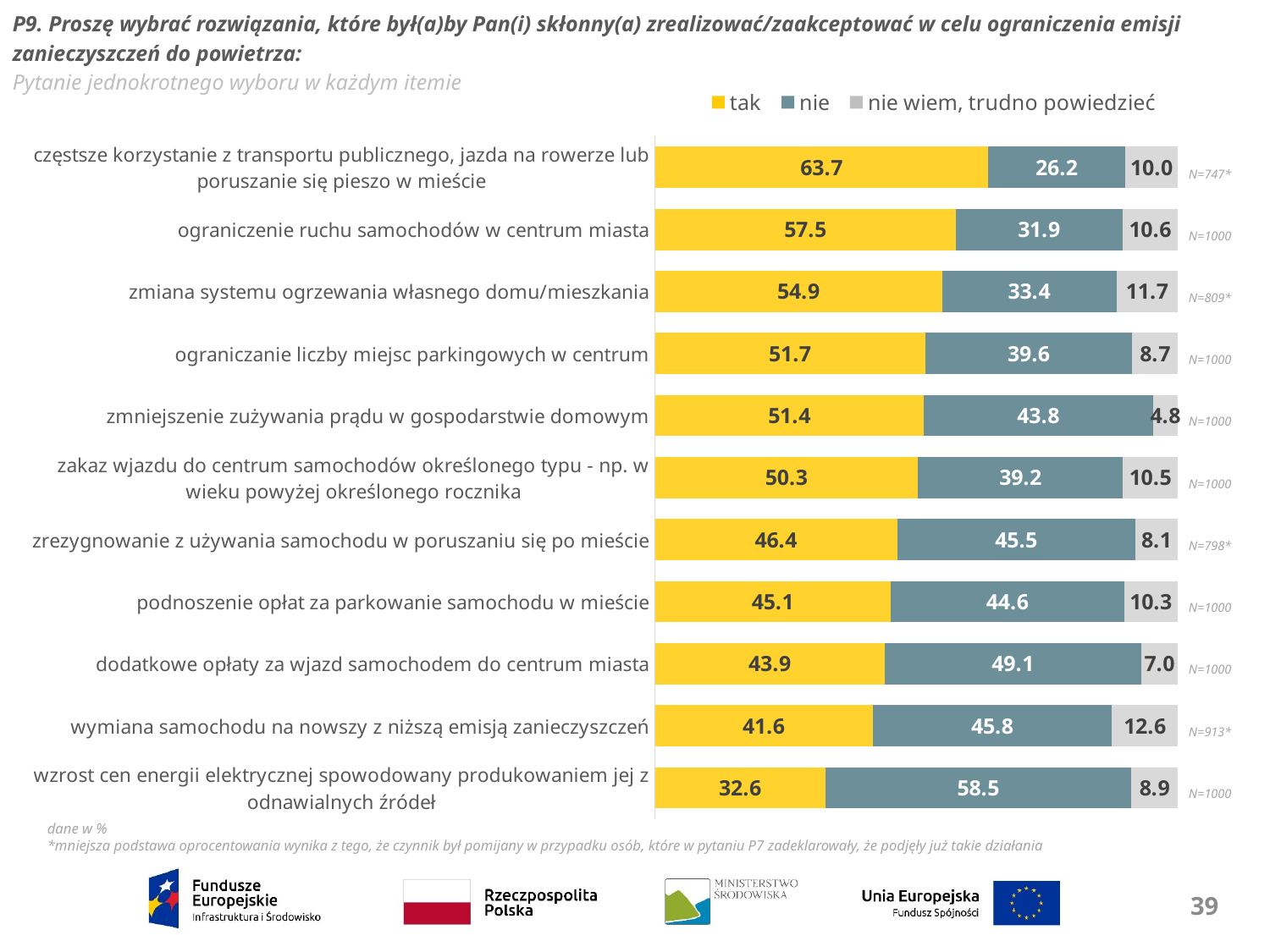
What is the difference between the "tak" and "nie" values for "ograniczanie liczby miejsc parkingowych w centrum"? 12.1 What is the value for "tak" for "ograniczenie ruchu samochodów w centrum miasta"? 57.5 How many categories (items) are shown in the chart? 11 Which category has the lowest value for "nie wiem, trudno powiedzieć"? zmniejszenie zużywania prądu w gospodarstwie domowym Which category has the highest value for "tak"? częstsze korzystanie z transportu publicznego, jazda na rowerze lub poruszanie się pieszo w mieście For "dodatkowe opłaty za wjazd samochodem do centrum miasta", which is larger: "tak" or "nie"? nie Which category has the lowest value for "tak"? wzrost cen energii elektrycznej spowodowany produkowaniem jej z odnawialnych źródeł What is the total of the stacked bar for "częstsze korzystanie z transportu publicznego, jazda na rowerze lub poruszanie się pieszo w mieście"? 99.9 What is the value for "nie wiem, trudno powiedzieć" for "wymiana samochodu na nowszy z niższą emisją zanieczyszczeń"? 12.6 What kind of chart is shown on the slide? stacked bar chart How many series does the legend list? 3 What is the value for "nie" for "wzrost cen energii elektrycznej spowodowany produkowaniem jej z odnawialnych źródeł"? 58.5